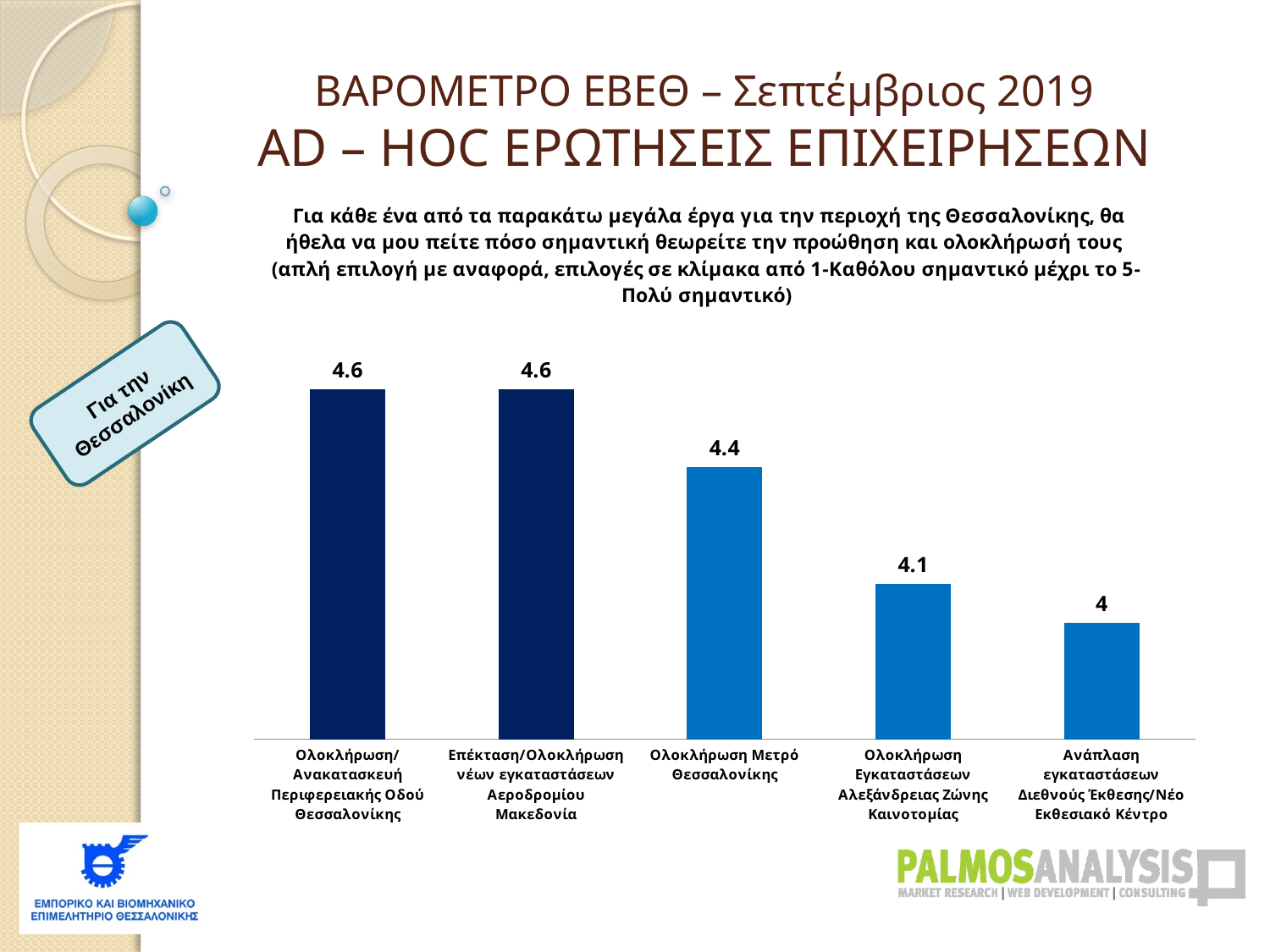
What is the value for Ανάπλαση εγκαταστάσεων Διεθνούς Έκθεσης/Νέο Εκθεσιακό Κέντρο? 4 Do the values rise or fall from left to right across the chart? Fall What is the difference between the value for Ολοκλήρωση/Ανακατασκευή Περιφερειακής Οδού Θεσσαλονίκης and the value for Ανάπλαση εγκαταστάσεων Διεθνούς Έκθεσης/Νέο Εκθεσιακό Κέντρο? 0.6 How many bars are drawn in the darker navy colour? 2 Which category has the lowest value? Ανάπλαση εγκαταστάσεων Διεθνούς Έκθεσης/Νέο Εκθεσιακό Κέντρο What kind of chart is shown on the slide? Bar chart What is the difference between the value for Ολοκλήρωση Μετρό Θεσσαλονίκης and the value for Ολοκλήρωση Εγκαταστάσεων Αλεξάνδρειας Ζώνης Καινοτομίας? 0.3 What is the value for Επέκταση/Ολοκλήρωση νέων εγκαταστάσεων Αεροδρομίου Μακεδονία? 4.6 What is the value for Ολοκλήρωση Εγκαταστάσεων Αλεξάνδρειας Ζώνης Καινοτομίας? 4.1 What is the value for Ολοκλήρωση Μετρό Θεσσαλονίκης? 4.4 How many categories are shown in the chart? 5 Which is larger, the value for Ολοκλήρωση Μετρό Θεσσαλονίκης or the value for Ανάπλαση εγκαταστάσεων Διεθνούς Έκθεσης/Νέο Εκθεσιακό Κέντρο? Ολοκλήρωση Μετρό Θεσσαλονίκης